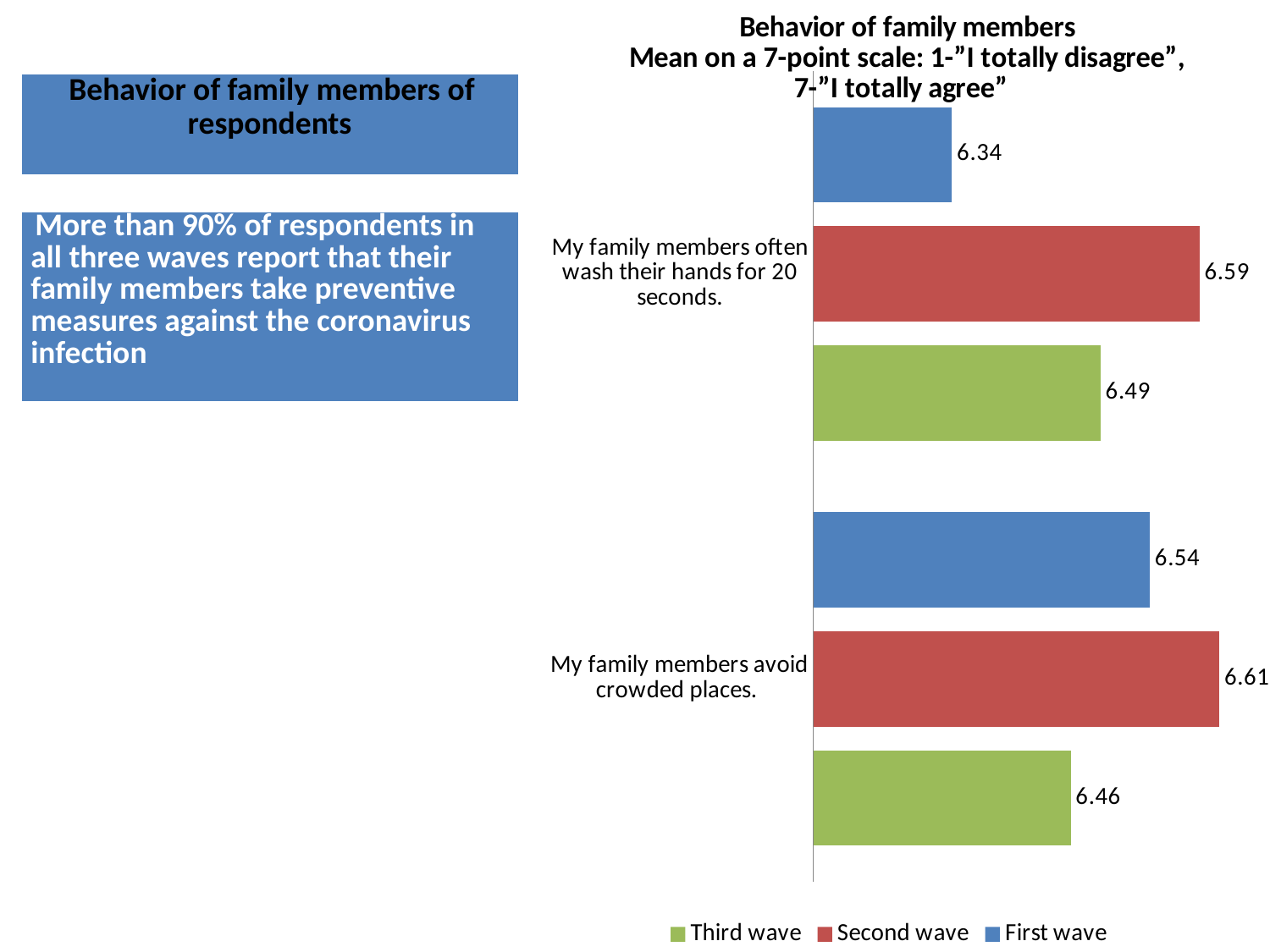
What is the Second wave value for "My family members avoid crowded places."? 6.61 What kind of chart is shown on the slide? Bar chart What is the Third wave value for "My family members avoid crowded places."? 6.46 Which wave has the highest value for "My family members often wash their hands for 20 seconds."? Second wave What is the First wave value for "My family members often wash their hands for 20 seconds."? 6.34 How many series does the legend list? 3 Which colour represents the Second wave in the chart? Red What is the difference between the Second wave and First wave values for "My family members often wash their hands for 20 seconds."? 0.25 How many statements (categories) are shown on the chart? 2 What is the Third wave value for "My family members often wash their hands for 20 seconds."? 6.49 Which is larger: the First wave value for "My family members avoid crowded places." or the First wave value for "My family members often wash their hands for 20 seconds."? My family members avoid crowded places. Which wave has the lowest value for "My family members avoid crowded places."? Third wave